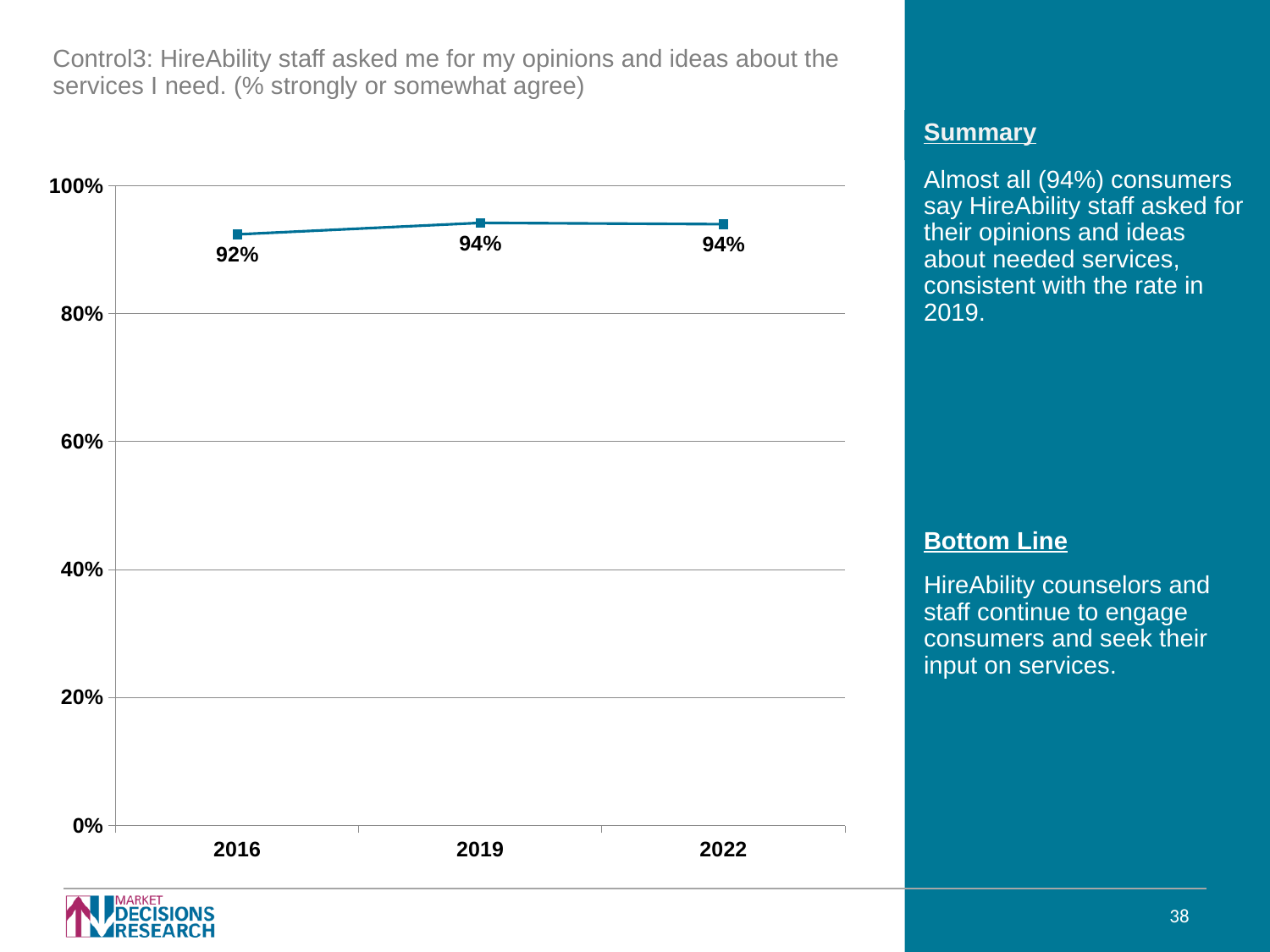
What is the value for 2022? 94% Does the value rise or fall from 2016 to 2019? rise Which year has the lowest value? 2016 What is the highest value shown on the y axis? 100% What is the difference between the values for 2019 and 2016? 2% What kind of chart is shown on the slide? line chart What is the first year shown on the x axis? 2016 What is the value for 2019? 94% How many years are plotted on the chart? 3 What is the value for 2016? 92% Is the value for 2016 greater or less than 80%? greater Which is larger, the value for 2016 or the value for 2022? 2022